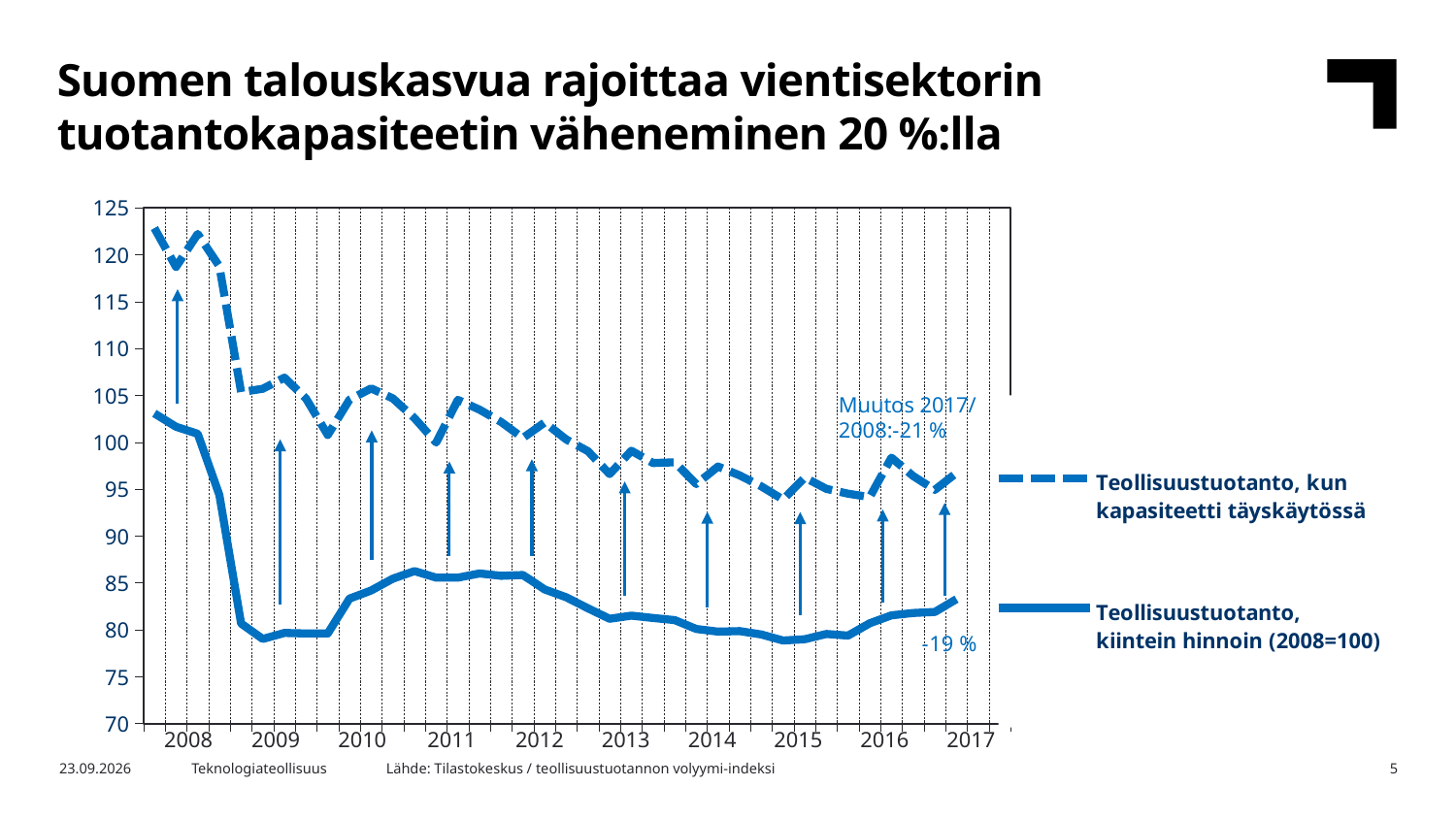
How many years are labelled on the x axis of the chart? 10 What change for 2017 versus 2008 is annotated for the dashed series (Teollisuustuotanto, kun kapasiteetti täyskäytössä)? -21 % What percentage change is annotated near the end of the solid series (Teollisuustuotanto, kiintein hinnoin)? -19 % Is the value of the solid series (Teollisuustuotanto, kiintein hinnoin) at the start of 2009 greater or less than 85? less Does the dashed series (Teollisuustuotanto, kun kapasiteetti täyskäytössä) rise or fall overall from 2008 to 2017? fall How many series does the chart's legend list? 2 Which series is drawn with a dashed line? Teollisuustuotanto, kun kapasiteetti täyskäytössä Is the value of the solid series (Teollisuustuotanto, kiintein hinnoin) in 2015 greater or less than 85? less Does the solid series (Teollisuustuotanto, kiintein hinnoin) rise or fall overall from 2008 to 2017? fall Is the value of the dashed series (Teollisuustuotanto, kun kapasiteetti täyskäytössä) at the start of 2008 greater or less than 120? greater What kind of chart is shown on the slide? line chart In 2017, which series has the higher value: the dashed series (kapasiteetti täyskäytössä) or the solid series (kiintein hinnoin)? Teollisuustuotanto, kun kapasiteetti täyskäytössä